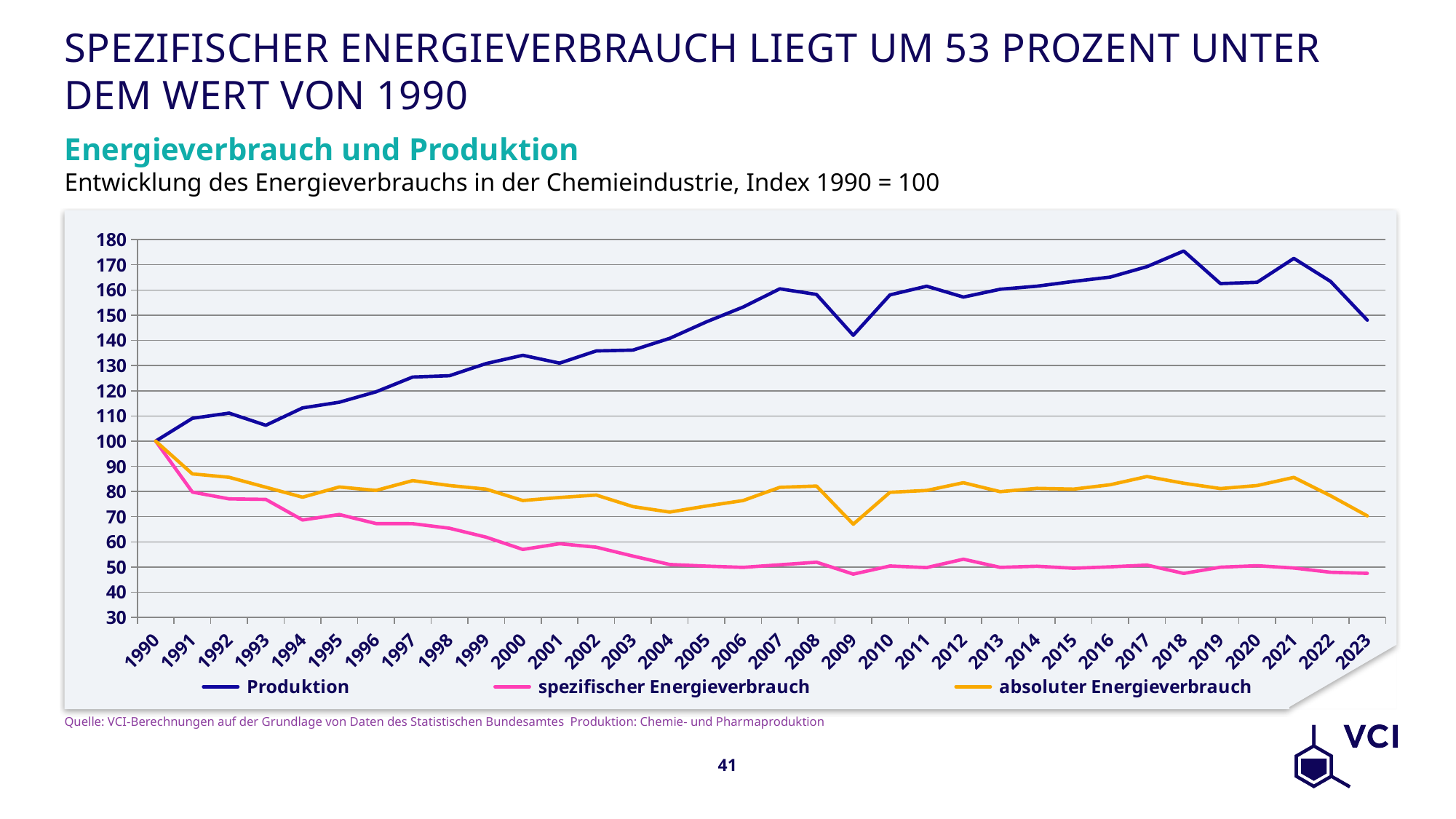
Is the value for Produktion in 2009 greater or less than 150? less Is the value for Produktion in 2018 greater or less than 170? greater Which is larger in 2023: absoluter Energieverbrauch or spezifischer Energieverbrauch? absoluter Energieverbrauch In which year does Produktion reach its highest value? 2018 Is the value for absoluter Energieverbrauch in 2017 greater or less than 80? greater Does spezifischer Energieverbrauch rise or fall overall from 1990 to 2023? fall How many years are plotted along the x axis? 34 What is the value of Produktion in 1990? 100 What kind of chart is shown on the slide? line chart In which year is spezifischer Energieverbrauch at its highest? 1990 How many series does the legend list? 3